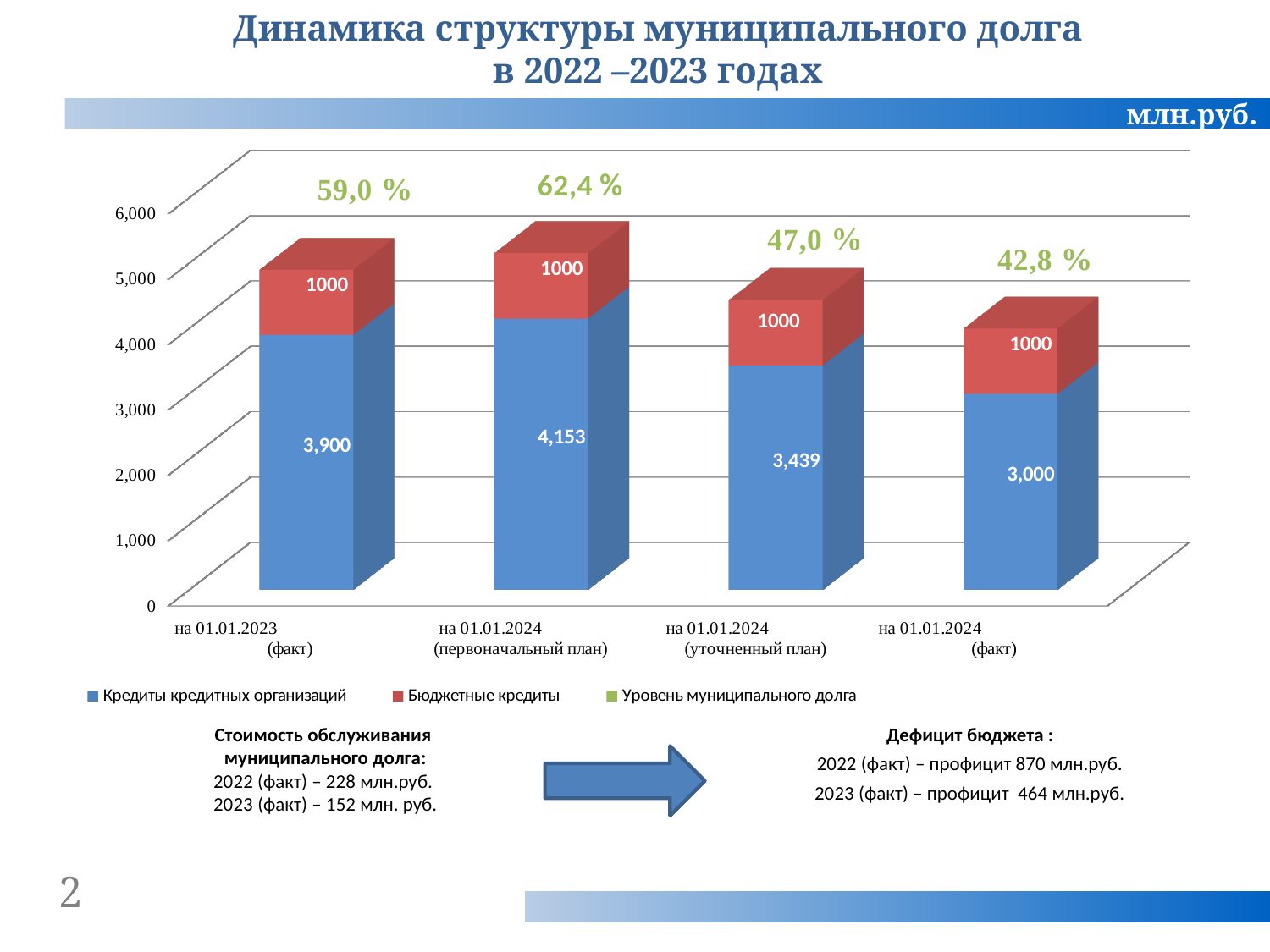
What is the difference between Кредиты кредитных организаций for на 01.01.2024 (первоначальный план) and на 01.01.2024 (факт)? 1,153 How many series does the chart legend list? 3 What is the total of the stacked bar for на 01.01.2023 (факт)? 4,900 What is the Уровень муниципального долга shown for на 01.01.2024 (первоначальный план)? 62,4 % What kind of chart is shown on the slide? Stacked bar chart Which is larger: Кредиты кредитных организаций for на 01.01.2023 (факт) or for на 01.01.2024 (уточненный план)? на 01.01.2023 (факт) Which category has the lowest value of Кредиты кредитных организаций? на 01.01.2024 (факт) What is the value of Кредиты кредитных организаций for на 01.01.2023 (факт)? 3,900 What is the value of Бюджетные кредиты for на 01.01.2024 (факт)? 1000 Which category has the highest value of Кредиты кредитных организаций? на 01.01.2024 (первоначальный план) What is the value of Кредиты кредитных организаций for на 01.01.2024 (уточненный план)? 3,439 How many categories are shown on the x axis of the chart? 4